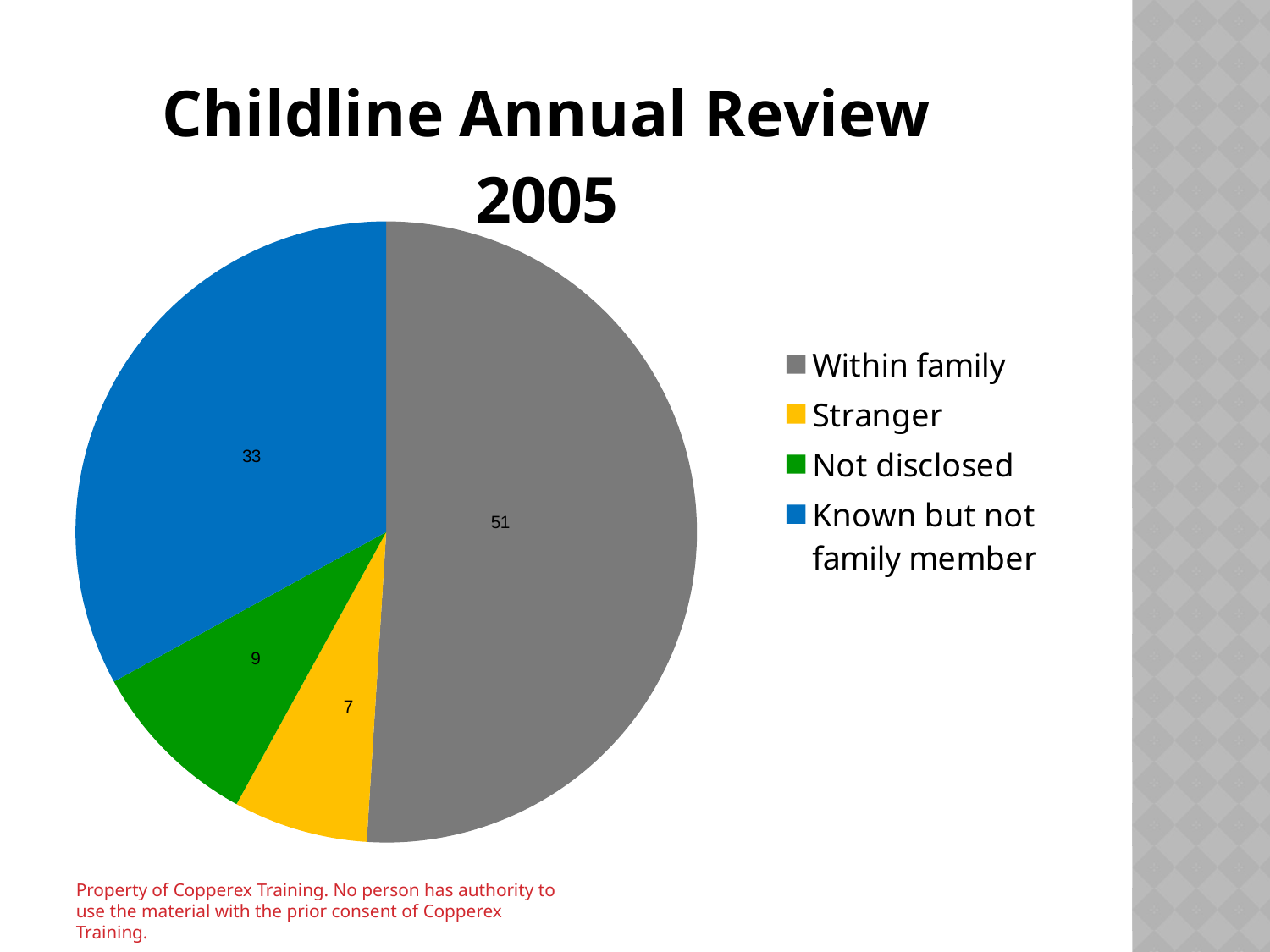
Which is larger, Not disclosed or Stranger? Not disclosed What is the value for Not disclosed? 9 What is the value for Within family? 51 What share of the pie does Within family represent? 51% Which category has the smallest slice? Stranger Which category has the largest slice? Within family What is the difference between the values for Within family and Known but not family member? 18 How many slices does the pie chart have? 4 What is the value for Known but not family member? 33 What type of chart is shown on the slide? Pie chart What colour is the Known but not family member slice? Blue What is the value for Stranger? 7